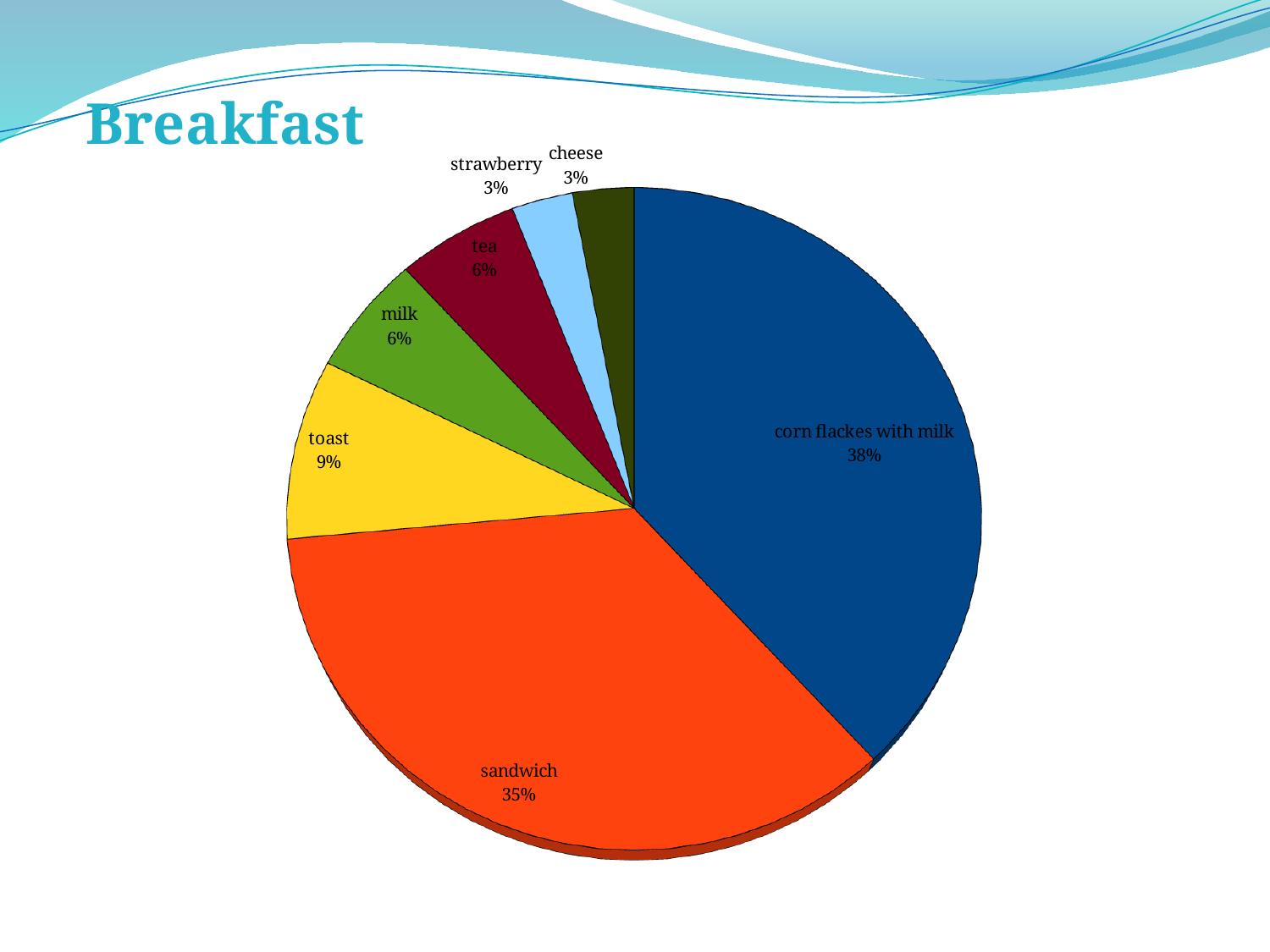
What share of the pie does corn flackes with milk have? 38% How many slices does the pie chart have? 7 Which category has the largest slice of the pie? corn flackes with milk What colour is the sandwich slice? orange What share of the pie does tea have? 6% What is the difference between the shares for corn flackes with milk and sandwich? 3% What share of the pie does sandwich have? 35% What kind of chart is shown on the slide? pie chart Which is larger, the share for toast or the share for milk? toast What is the title of the slide containing the pie chart? Breakfast What is the difference between the shares for toast and cheese? 6%